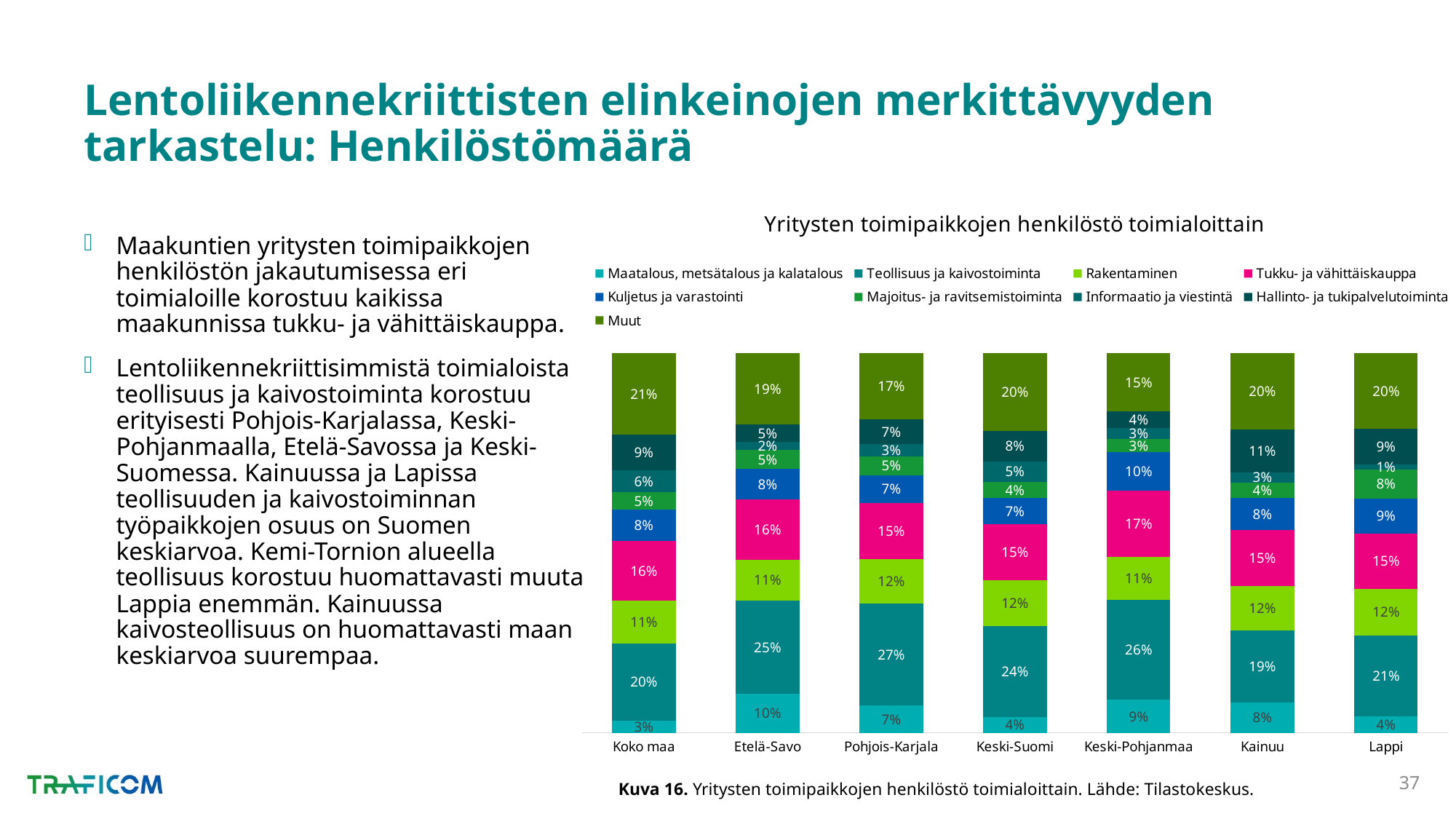
How many regions (categories) are shown on the x axis of the chart? 7 Which region has the highest share of Teollisuus ja kaivostoiminta? Pohjois-Karjala Which region has the lowest share of Maatalous, metsätalous ja kalatalous? Koko maa What is the share of Teollisuus ja kaivostoiminta in Pohjois-Karjala? 27% What is the share of Hallinto- ja tukipalvelutoiminta in Kainuu? 11% What is the share of Maatalous, metsätalous ja kalatalous in Etelä-Savo? 10% What is the share of Tukku- ja vähittäiskauppa in Keski-Pohjanmaa? 17% How many series does the chart legend list? 9 What is the title of the chart? Yritysten toimipaikkojen henkilöstö toimialoittain Which is larger: the Kuljetus ja varastointi share in Keski-Pohjanmaa or in Lappi? Keski-Pohjanmaa What is the difference between the Teollisuus ja kaivostoiminta share in Keski-Pohjanmaa and in Kainuu? 7 percentage points What type of chart is shown on the slide? Stacked bar chart